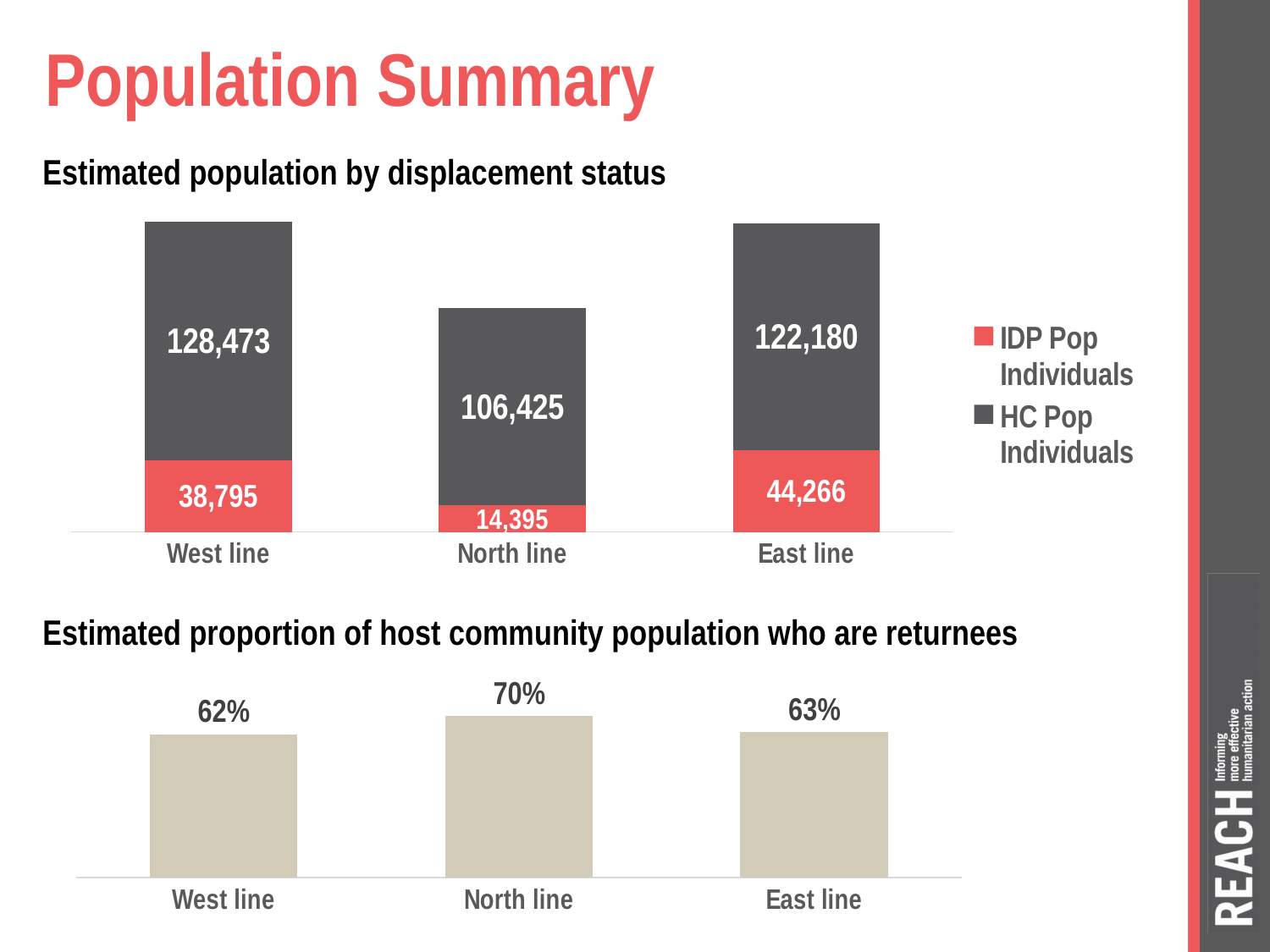
How many series does the legend of the 'Estimated population by displacement status' chart list? 2 In the 'Estimated population by displacement status' chart, which category has the lowest HC Pop Individuals value? North line In the 'Estimated population by displacement status' chart, what is the total of the stacked bar for North line? 120,820 What kind of chart is the 'Estimated proportion of host community population who are returnees' chart? Bar chart In the 'Estimated population by displacement status' chart, what is the HC Pop Individuals value for North line? 106,425 In the 'Estimated population by displacement status' chart, which colour represents IDP Pop Individuals? Red In the 'Estimated proportion of host community population who are returnees' chart, how many categories are shown? 3 In the 'Estimated proportion of host community population who are returnees' chart, which category has the lowest value? West line In the 'Estimated population by displacement status' chart, what is the IDP Pop Individuals value for West line? 38,795 In the 'Estimated population by displacement status' chart, which category has the highest IDP Pop Individuals value? East line In the 'Estimated population by displacement status' chart, what is the difference between the HC Pop Individuals values for West line and North line? 22,048 In the 'Estimated proportion of host community population who are returnees' chart, what is the value for North line? 70%